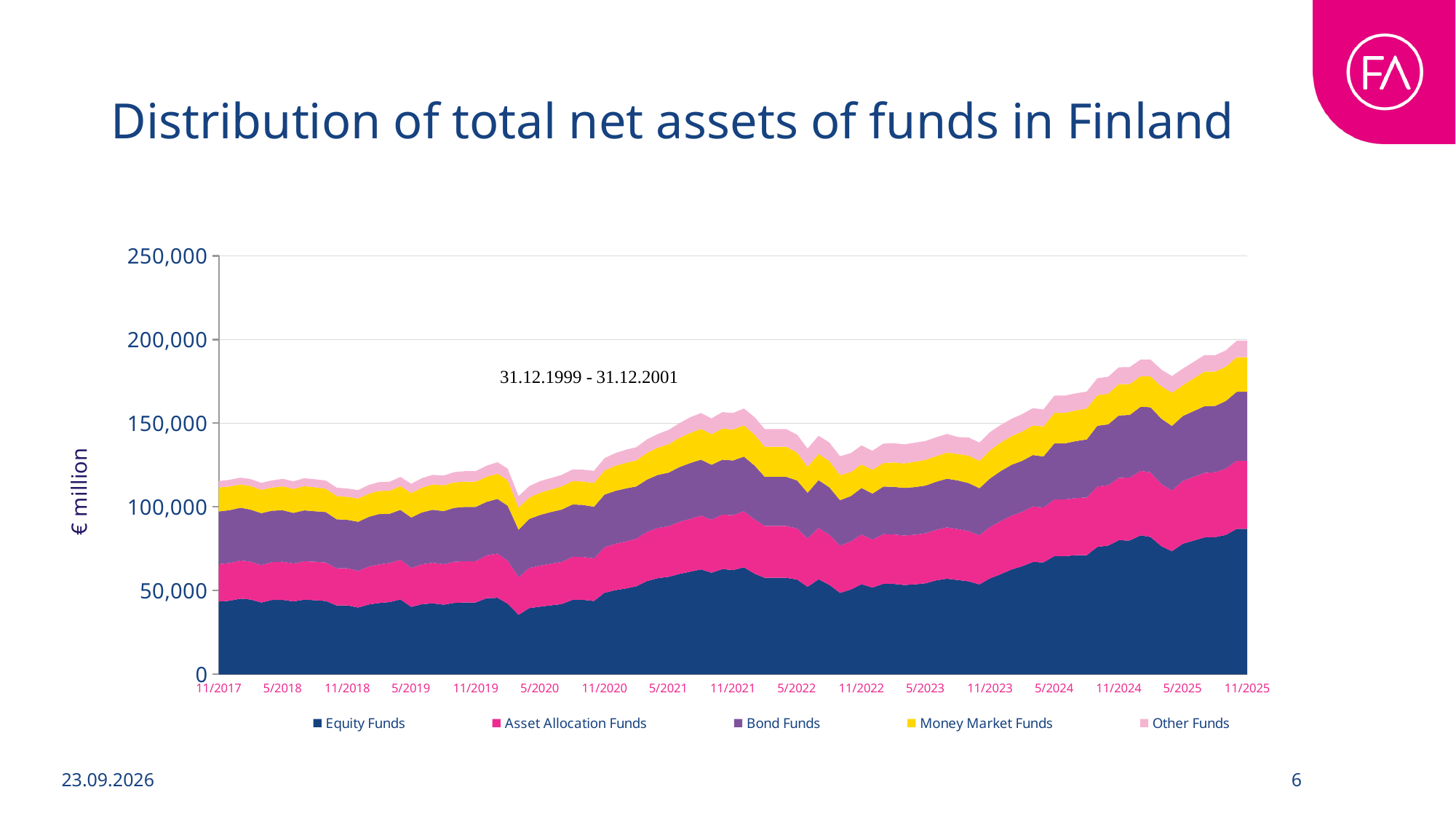
What is the title of the chart? Distribution of total net assets of funds in Finland Is the total net assets value at 11/2021 greater or less than 150,000? greater Is the value for Equity Funds at 11/2017 greater or less than 50,000? less What kind of chart is shown on the slide? Stacked area chart What is the label on the vertical axis? € million Does the total net assets of funds rise or fall overall from 11/2017 to 11/2025? Rise At 11/2025, which is larger: Equity Funds or Other Funds? Equity Funds How many series does the legend list? 5 Is the value for Equity Funds at 11/2025 greater or less than 100,000? less Which fund type has the largest net assets at 11/2025? Equity Funds